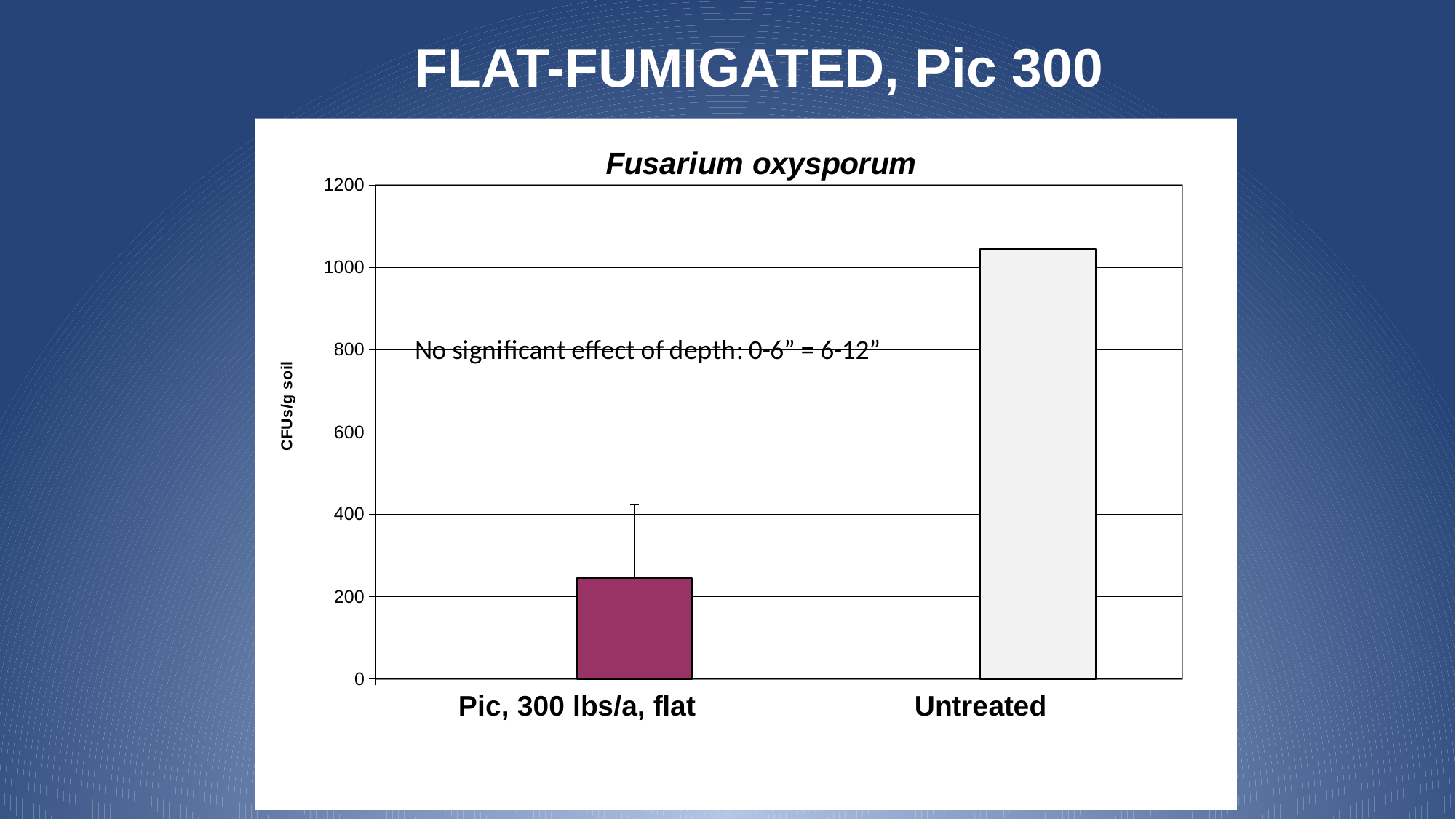
Which category has the highest value? Untreated Is the value for Untreated greater or less than 1000? greater What is the title of the chart? Fusarium oxysporum Which is larger, the value for Untreated or the value for Pic, 300 lbs/a, flat? Untreated How many categories are plotted on the x axis? 2 What is the label of the y axis? CFUs/g soil Which category has the lowest value? Pic, 300 lbs/a, flat Is the value for Pic, 300 lbs/a, flat greater or less than 200? greater Is the value for Untreated greater or less than 1200? less What kind of chart is shown on the slide? bar chart